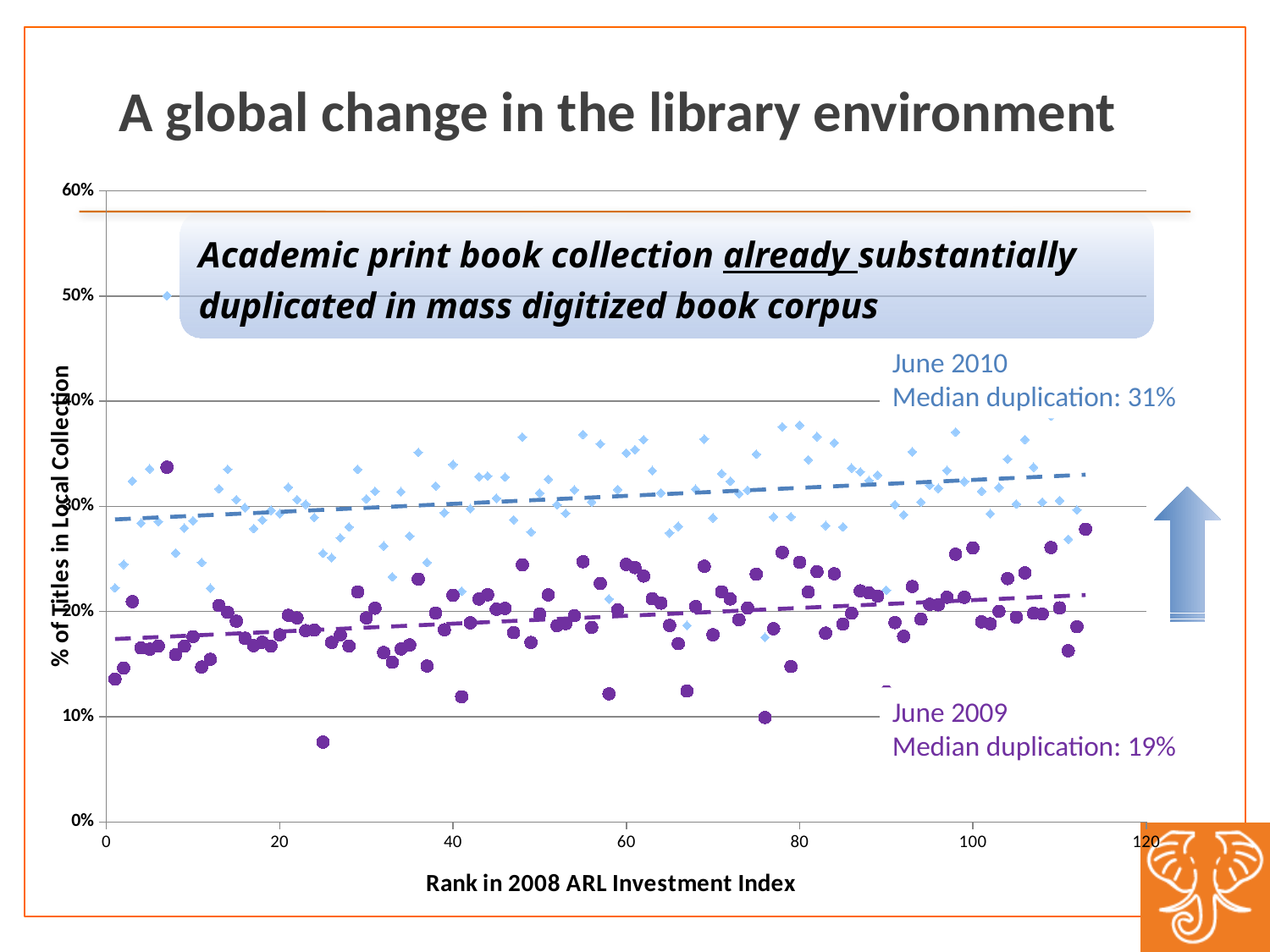
Do the dashed trend lines for both series rise or fall as rank increases along the x axis? Rise What is the highest value shown on the y axis? 60% What is the title of the y axis? % of Titles in Local Collection Is the June 2009 median duplication greater or less than 20%? less Is the lowest June 2009 data point (near rank 25) greater or less than 10%? less What is the median duplication for June 2009 according to the chart annotation? 19% How many data series are plotted on the chart? 2 By how many percentage points does the June 2010 median duplication exceed the June 2009 median duplication? 12 percentage points What is the median duplication for June 2010 according to the chart annotation? 31% What kind of chart is shown on the slide? Scatter chart Which series has the higher median duplication, June 2010 or June 2009? June 2010 What is the title of the x axis? Rank in 2008 ARL Investment Index